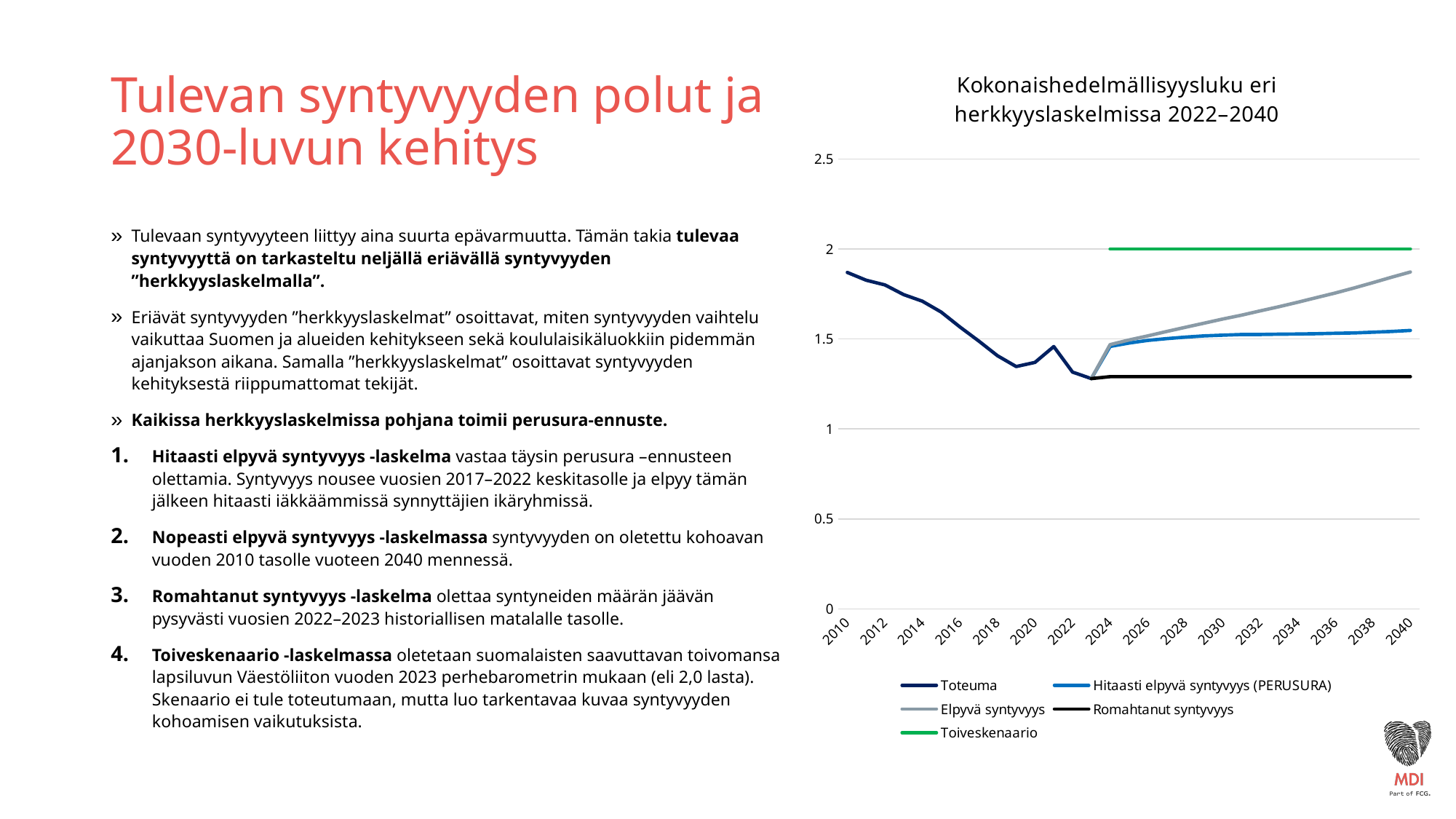
What kind of chart is shown on the slide? Line chart Is the value of Romahtanut syntyvyys in 2040 greater or less than 1.5? less Which series has the lowest value in 2040? Romahtanut syntyvyys Which series has the highest value in 2040? Toiveskenaario In 2040, which is higher: Elpyvä syntyvyys or Hitaasti elpyvä syntyvyys (PERUSURA)? Elpyvä syntyvyys What is the title of the chart? Kokonaishedelmällisyysluku eri herkkyyslaskelmissa 2022–2040 Is the value of Toteuma in 2010 greater or less than 1.5? greater Does the Toteuma line generally rise or fall between 2010 and 2020? Fall Is the value of Elpyvä syntyvyys in 2040 greater or less than 2? less Which colour is used for the Toiveskenaario line? Green What value does the Toiveskenaario line sit at in 2040? 2 How many series does the chart legend list? 5